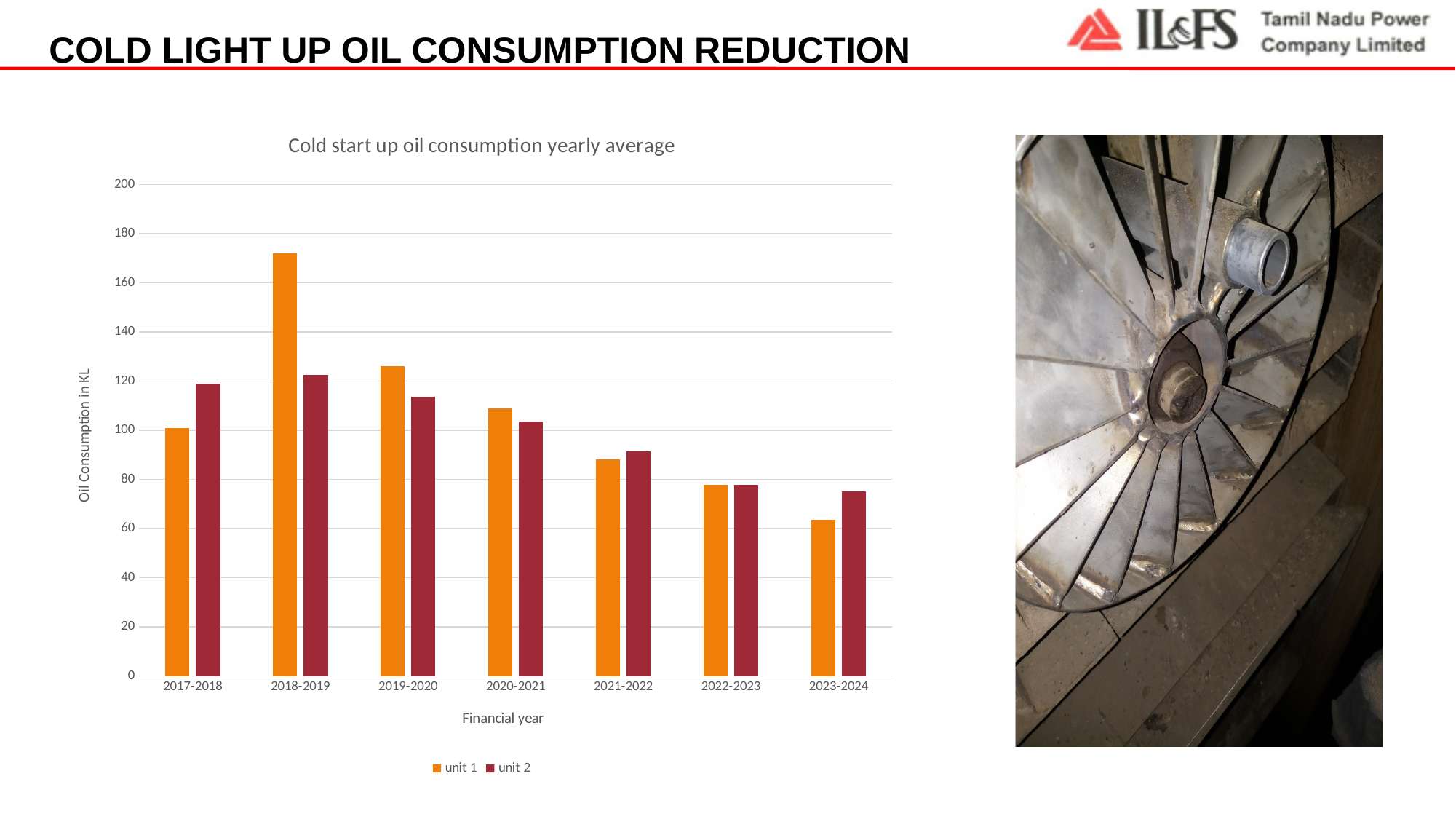
How many series does the chart legend list? 2 Is the unit 1 value for 2021-2022 greater or less than 100? less In which financial year is the unit 1 oil consumption highest? 2018-2019 From 2019-2020 to 2023-2024, does the unit 1 oil consumption rise or fall? fall Is the unit 1 value for 2018-2019 greater or less than 160? greater What is the title of the chart? Cold start up oil consumption yearly average What kind of chart is shown on the slide? bar chart In which financial year is the unit 1 oil consumption lowest? 2023-2024 How many financial years are shown on the x axis of the chart? 7 In 2017-2018, which unit has the higher oil consumption, unit 1 or unit 2? unit 2 Is the unit 2 value for 2023-2024 greater or less than 80? less In 2018-2019, which unit has the higher oil consumption, unit 1 or unit 2? unit 1